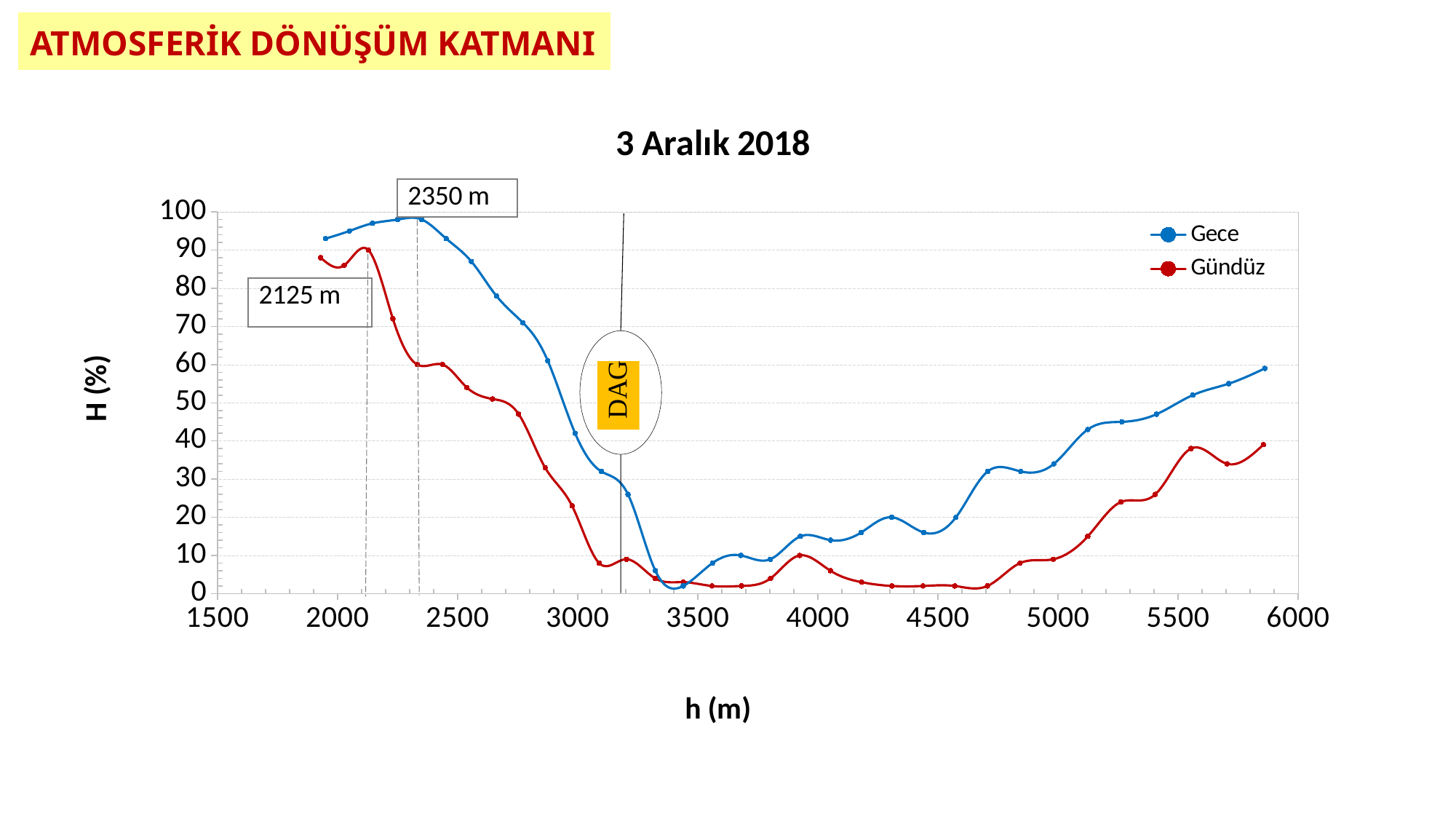
What is the title of the chart? 3 Aralık 2018 Is the Gündüz value at 2125 m greater or less than 80? greater How many series does the legend list? 2 Between 2350 m and 3400 m, does the Gece series rise or fall? fall Between 4700 m and 5900 m, does the Gündüz series generally rise or fall? rise At 2500 m, which series has the higher H (%) value, Gece or Gündüz? Gece Is the Gündüz value at 4500 m greater or less than 10? less What are the two series named in the legend? Gece and Gündüz Is the Gece value at the far right end of the chart (near 5900 m) greater or less than 50? greater Which is larger for the Gece series: the value at 2350 m or the value at 5900 m? the value at 2350 m What kind of chart is shown on the slide? line chart